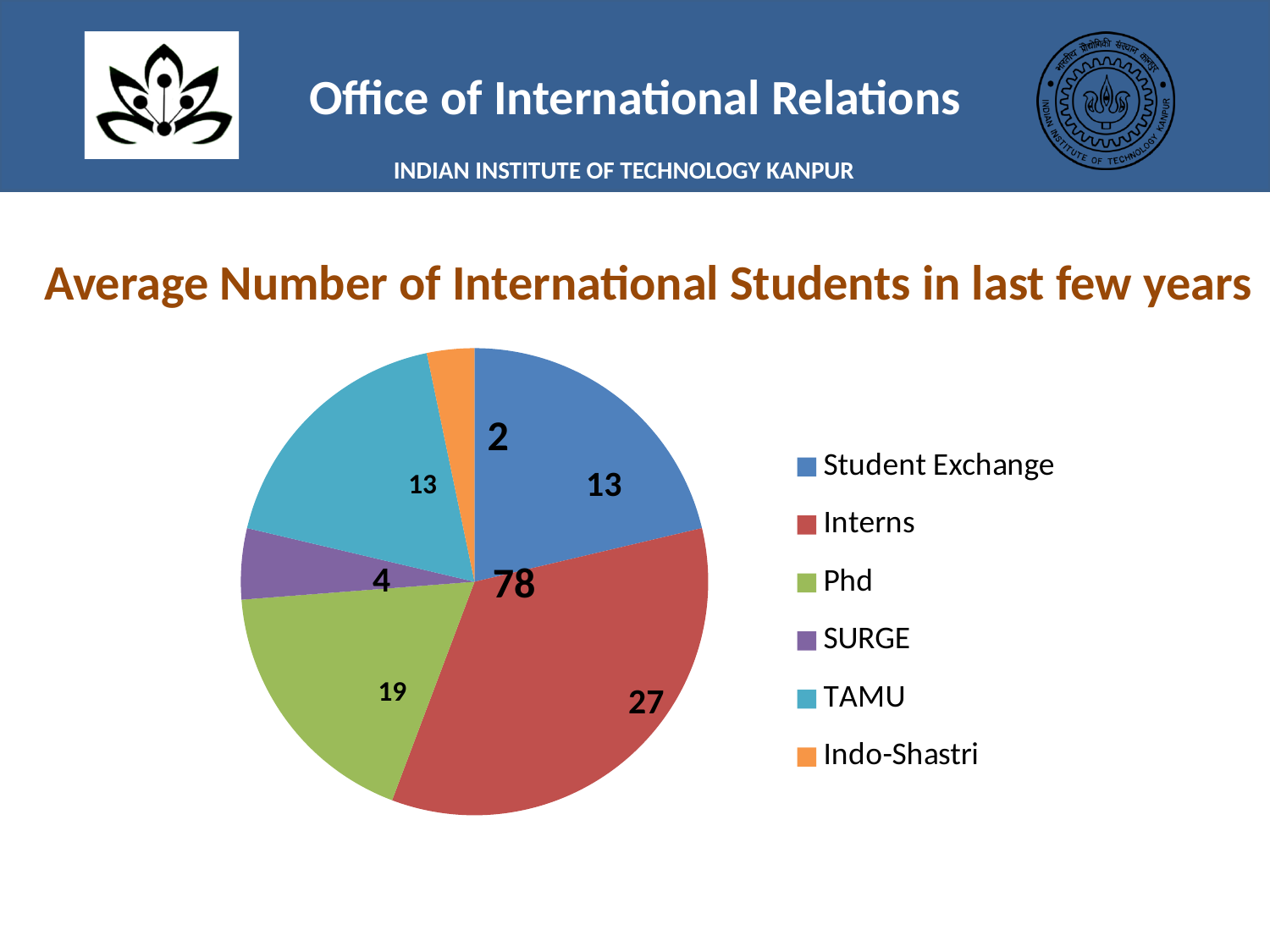
What is the value for Indo-Shastri in the pie chart? 2 Which is larger, the value for Phd or the value for Student Exchange? Phd How many categories does the pie chart show? 6 What kind of chart is shown on the slide? pie chart Which category has the largest slice of the pie chart? Interns What is the difference between the values for Interns and Phd? 8 What is the value for Interns in the pie chart? 27 What is the value for SURGE in the pie chart? 4 What is the value for Phd in the pie chart? 19 Which category has the smallest slice of the pie chart? Indo-Shastri What is the title of the chart on the slide? Average Number of International Students in last few years What is the value for Student Exchange in the pie chart? 13